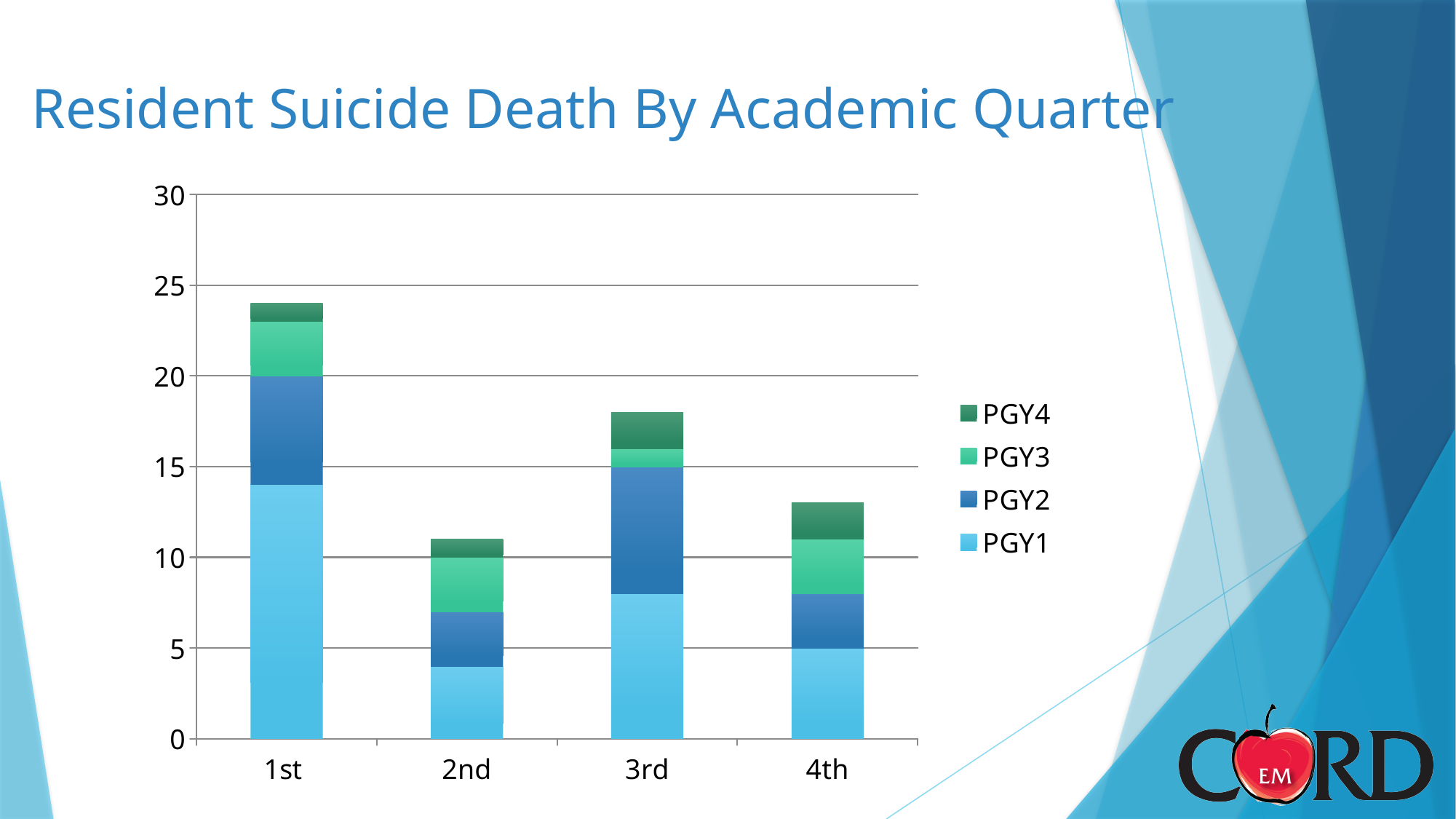
Which stacked bar is taller, the 3rd quarter or the 4th quarter? 3rd Is the total for the 2nd quarter greater or less than 15? less Which series forms the bottom segment of each stacked bar? PGY1 What is the title of the chart? Resident Suicide Death By Academic Quarter Is the total for the 1st quarter greater or less than 20? greater Which academic quarter has the shortest stacked bar? 2nd Is the total for the 3rd quarter greater or less than 15? greater Which academic quarter has the tallest stacked bar? 1st How many series does the legend list? 4 How many academic quarters are shown on the x axis? 4 What kind of chart is shown on the slide? bar chart